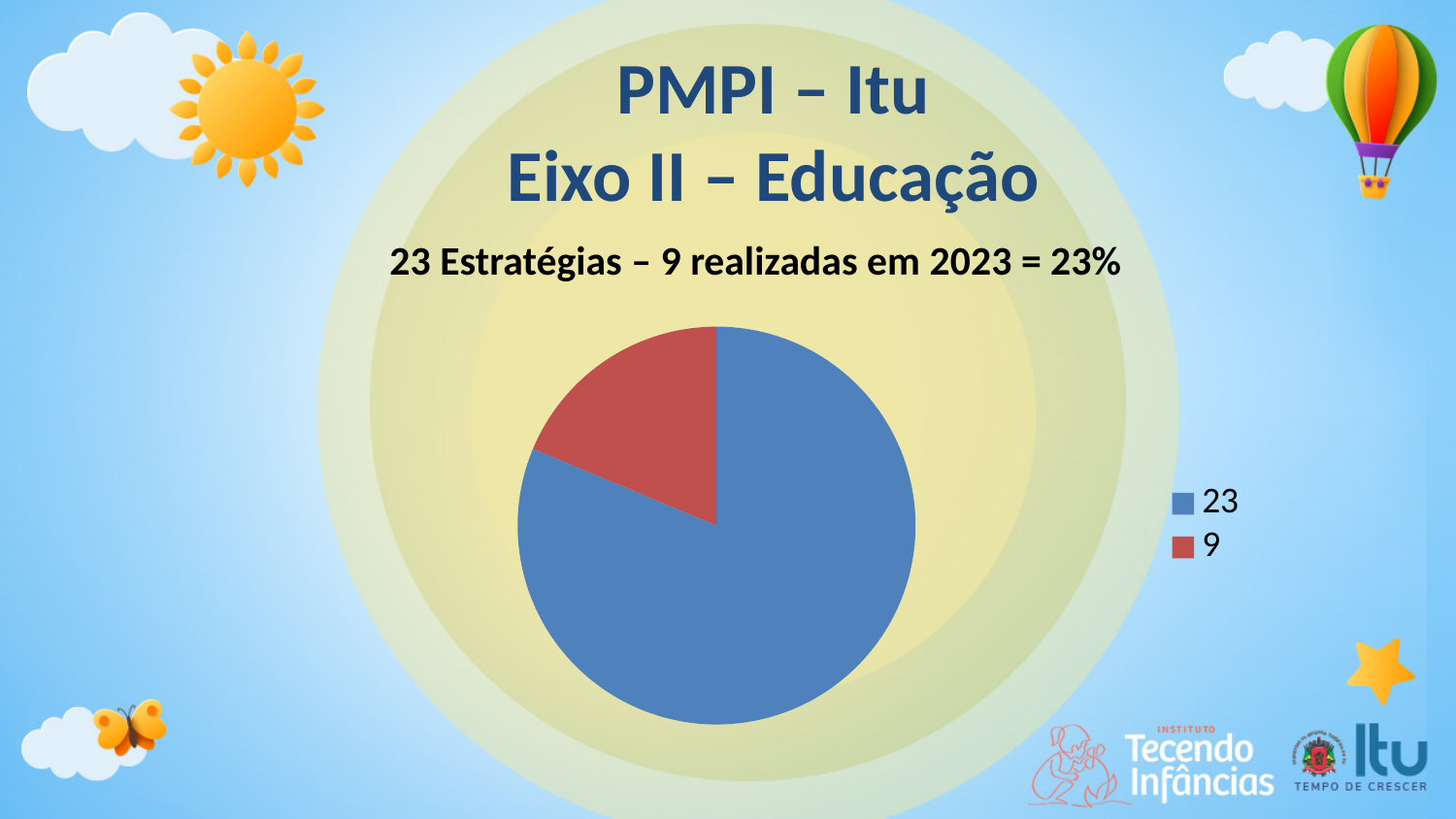
Which slice is larger in the pie chart, the one labelled 23 or the one labelled 9? 23 Which slice of the pie chart is the largest? 23 What kind of chart is shown on the slide? pie chart What are the two entries listed in the legend of the pie chart? 23 and 9 Which slice of the pie chart is the smallest? 9 How many entries does the legend of the pie chart list? 2 What colour is the slice labelled 9 in the pie chart? red How many slices does the pie chart have? 2